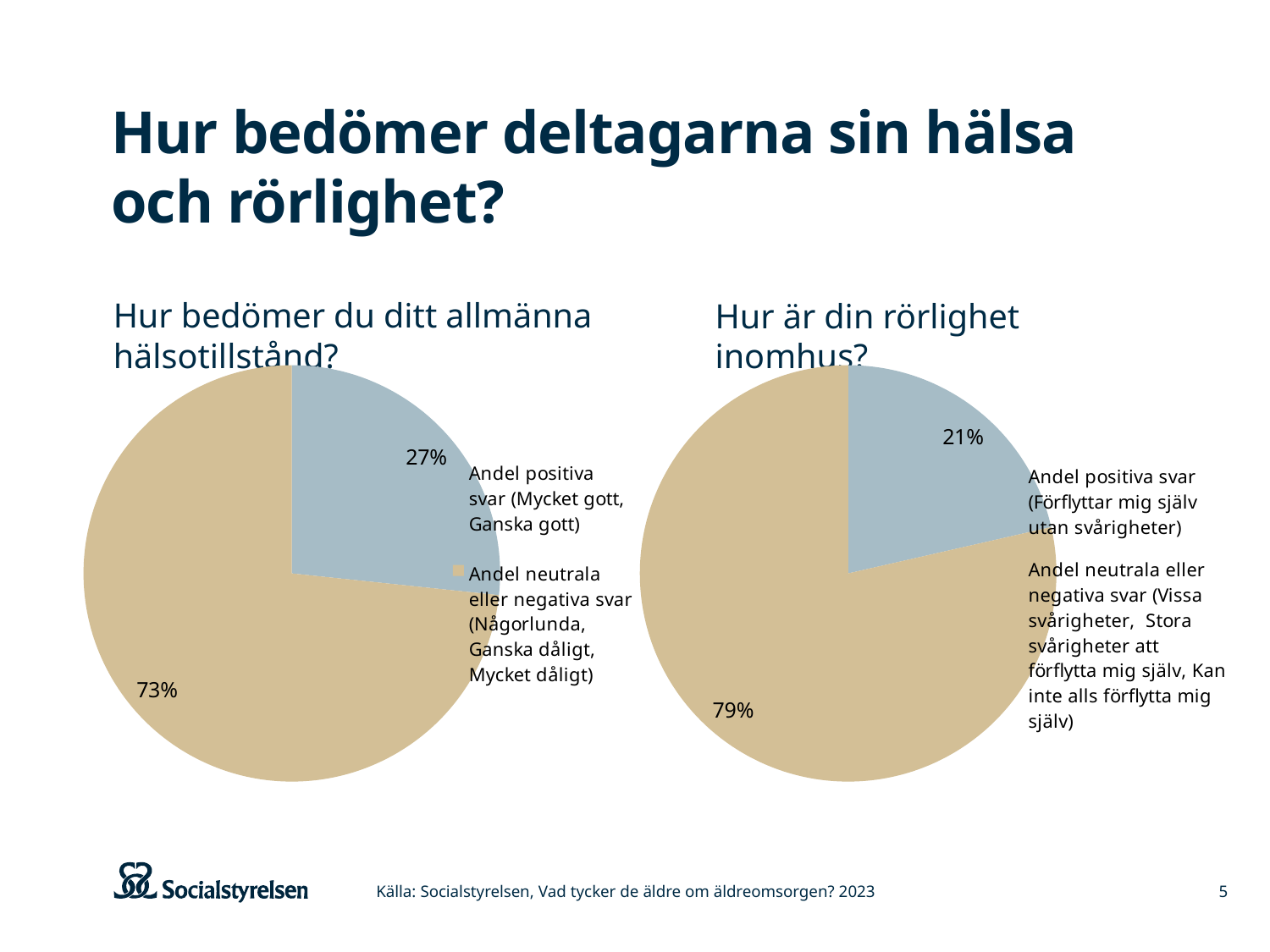
In the chart titled "Hur är din rörlighet inomhus?", what share is labelled for "Andel neutrala eller negativa svar"? 79% In the chart titled "Hur är din rörlighet inomhus?", what is the difference in percentage points between the two slices? 58 In the chart titled "Hur bedömer du ditt allmänna hälsotillstånd?", which category has the largest slice? Andel neutrala eller negativa svar In the chart titled "Hur är din rörlighet inomhus?", what share is labelled for "Andel positiva svar"? 21% In the chart titled "Hur bedömer du ditt allmänna hälsotillstånd?", what share is labelled for "Andel neutrala eller negativa svar"? 73% In the chart titled "Hur bedömer du ditt allmänna hälsotillstånd?", what colour is the slice for "Andel positiva svar"? Light blue How many slices does the chart titled "Hur är din rörlighet inomhus?" have? 2 Which chart shows a larger share of positive answers: the left chart ("Hur bedömer du ditt allmänna hälsotillstånd?") or the right chart ("Hur är din rörlighet inomhus?")? The left chart (Hur bedömer du ditt allmänna hälsotillstånd?) In the chart titled "Hur är din rörlighet inomhus?", which category has the smallest slice? Andel positiva svar In the chart titled "Hur bedömer du ditt allmänna hälsotillstånd?", what share is labelled for "Andel positiva svar"? 27% In the chart titled "Hur bedömer du ditt allmänna hälsotillstånd?", what is the difference in percentage points between the two slices? 46 What type of chart is used on the left side of the slide? Pie chart